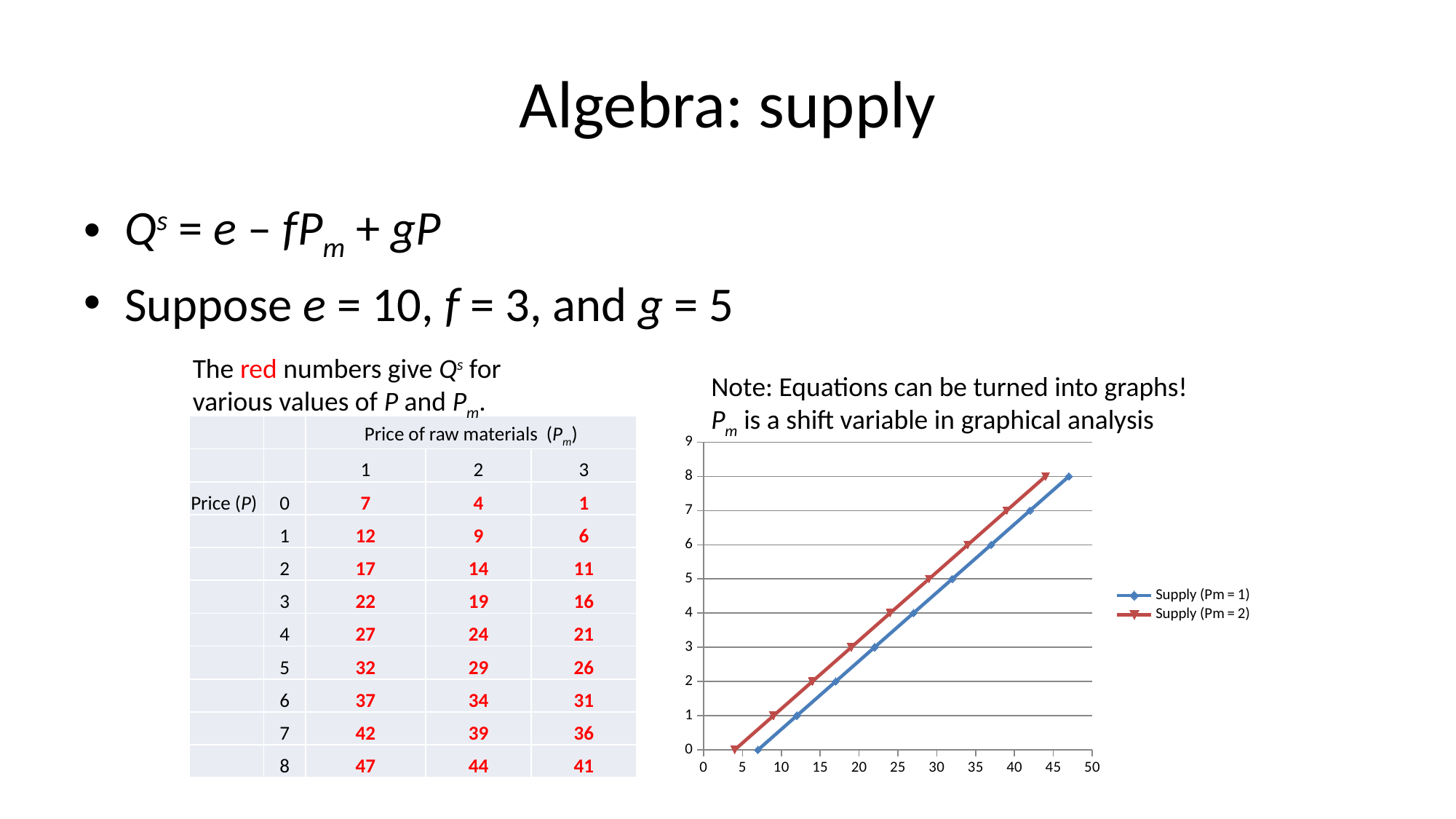
How many series does the chart's legend list? 2 What is the lowest y value of the Supply (Pm = 1) line? 0 Which colour is used for the Supply (Pm = 2) line in the chart? red At a y value of 5, which series has the larger x value, Supply (Pm = 1) or Supply (Pm = 2)? Supply (Pm = 1) Is the x value of the Supply (Pm = 1) point at y = 4 greater or less than 25? greater What are the two series named in the chart's legend? Supply (Pm = 1) and Supply (Pm = 2) Is the x value of the Supply (Pm = 1) point at y = 8 greater or less than 45? greater What is the highest y value of the Supply (Pm = 2) line? 8 Do the values on the chart rise or fall as you move along the x axis? rise How many data points are plotted on the Supply (Pm = 1) line? 9 What kind of chart is shown on the slide? line chart